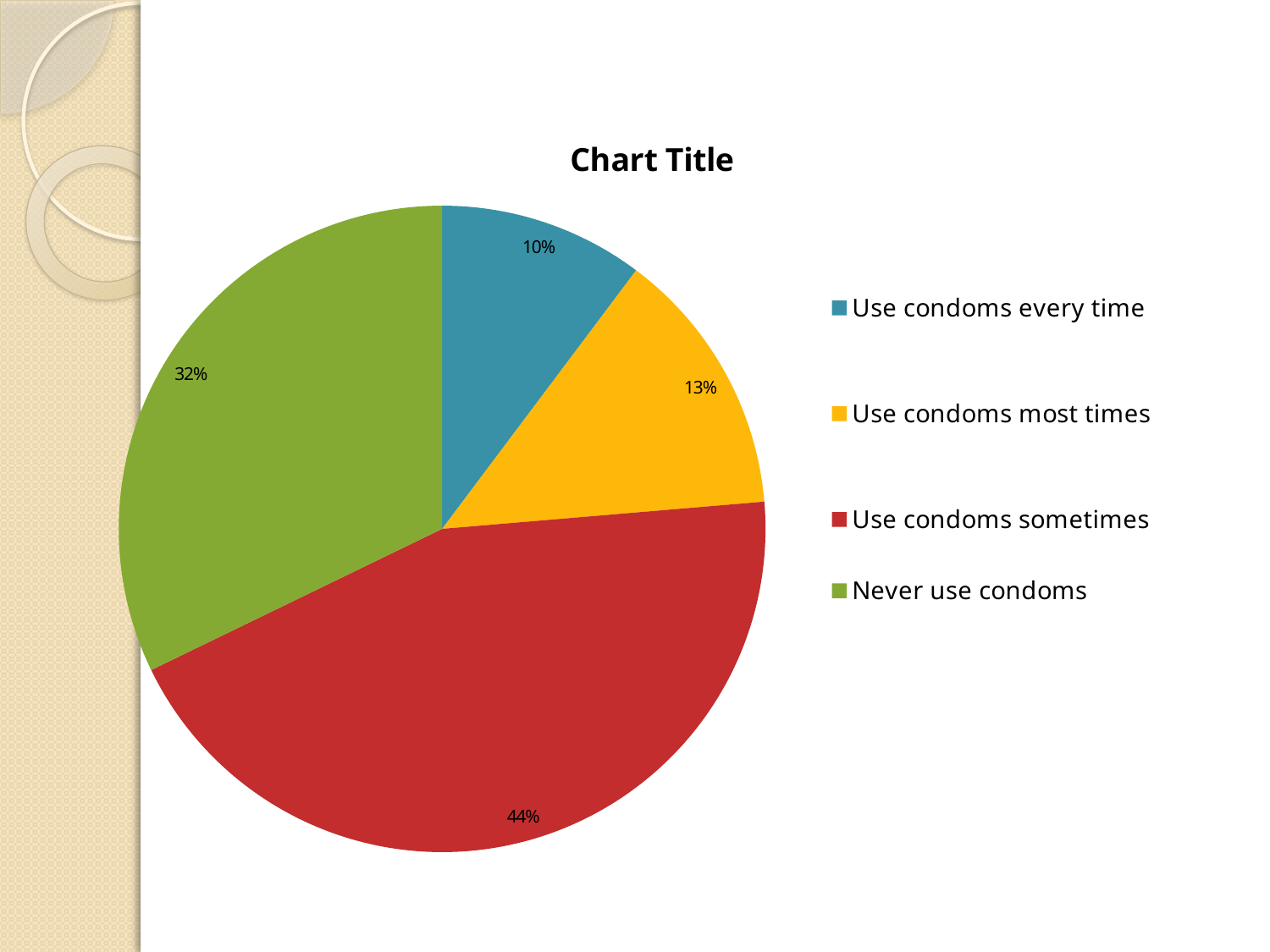
Which category has the smallest slice of the pie? Use condoms every time What is the title of the chart? Chart Title What kind of chart is shown on the slide? pie chart What percentage of the pie is 'Use condoms every time'? 10% What percentage of the pie is 'Use condoms most times'? 13% What percentage of the pie is 'Use condoms sometimes'? 44% What colour is the slice for 'Never use condoms'? green What is the difference in percentage points between 'Use condoms sometimes' and 'Never use condoms'? 12 Which is larger: the slice for 'Use condoms most times' or the slice for 'Use condoms every time'? Use condoms most times How many slices does the pie chart have? 4 What percentage of the pie is 'Never use condoms'? 32% Which category has the largest slice of the pie? Use condoms sometimes